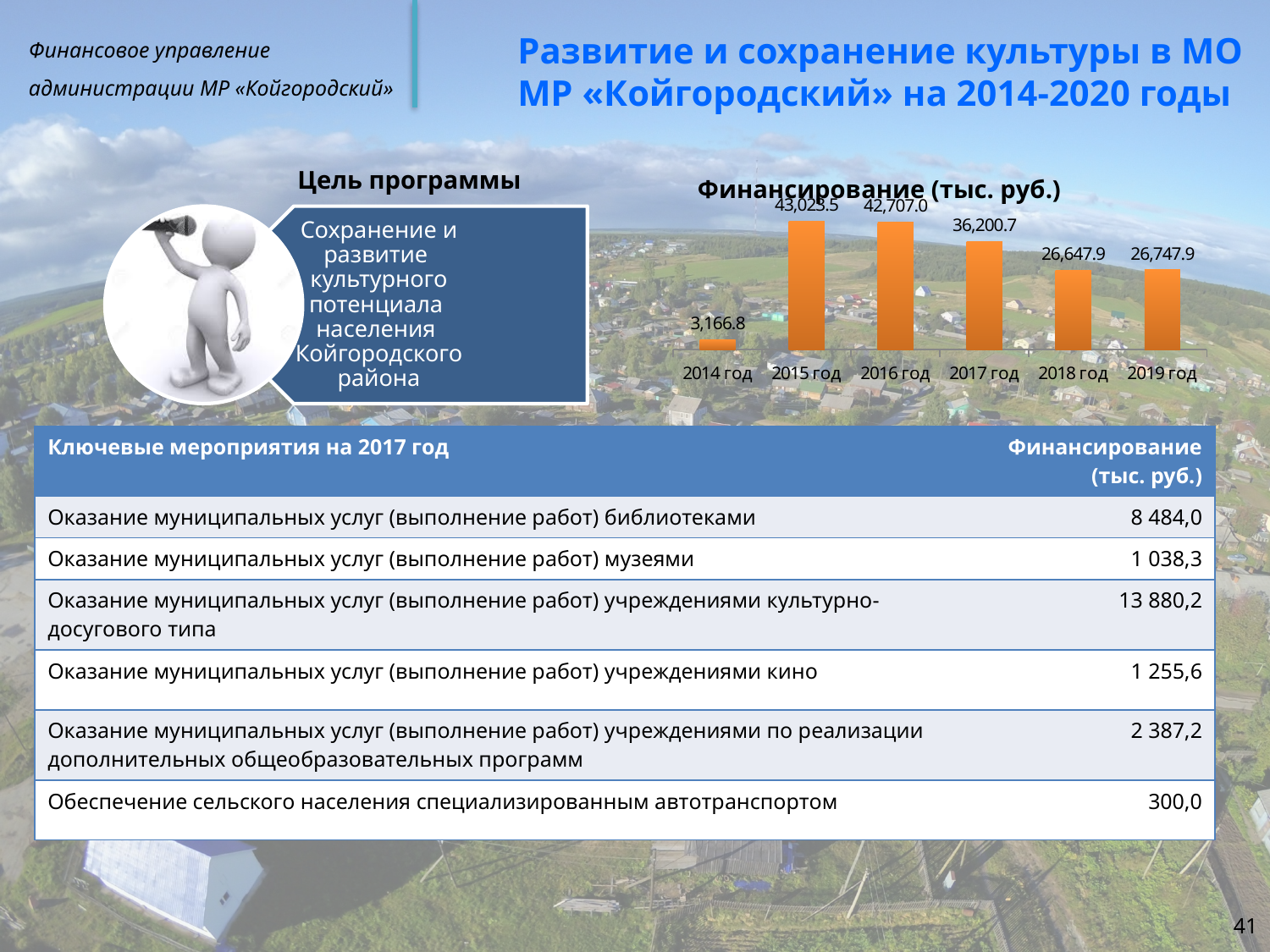
What is the difference between the values for 2019 год and 2018 год in the Финансирование (тыс. руб.) chart? 100.0 What is the difference between the values for 2015 год and 2014 год in the Финансирование (тыс. руб.) chart? 39,856.7 What kind of chart is the Финансирование (тыс. руб.) chart? bar chart What is the value for 2014 год in the Финансирование (тыс. руб.) chart? 3,166.8 Which is larger in the Финансирование (тыс. руб.) chart, the value for 2016 год or 2018 год? 2016 год Do the values in the Финансирование (тыс. руб.) chart rise or fall from 2015 год to 2018 год? fall Which year has the lowest value in the Финансирование (тыс. руб.) chart? 2014 год What is the value for 2017 год in the Финансирование (тыс. руб.) chart? 36,200.7 What is the value for 2019 год in the Финансирование (тыс. руб.) chart? 26,747.9 What is the value for 2015 год in the Финансирование (тыс. руб.) chart? 43,023.5 What is the difference between the values for 2016 год and 2017 год in the Финансирование (тыс. руб.) chart? 6,506.3 How many years are shown on the x axis of the Финансирование (тыс. руб.) chart? 6